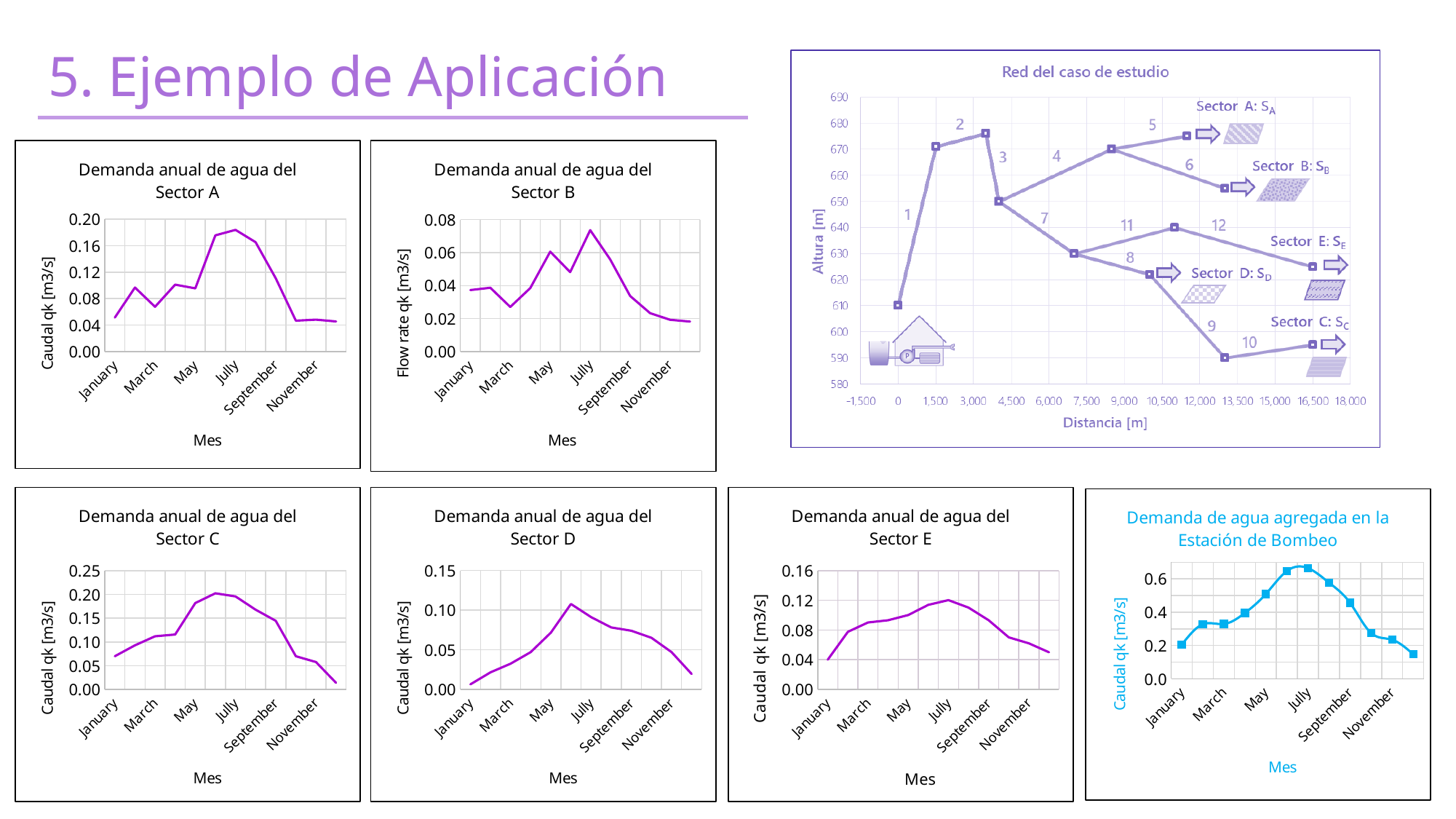
In the 'Demanda anual de agua del Sector B' chart, is the value for July greater or less than 0.06? greater What kind of chart is 'Demanda anual de agua del Sector A'? line chart In the 'Demanda anual de agua del Sector C' chart, is the value for June greater or less than 0.15? greater In the 'Demanda de agua agregada en la Estación de Bombeo' chart, is the value for December greater or less than 0.2? less In the 'Demanda anual de agua del Sector D' chart, which month has the lowest value? January What is the x-axis label of the 'Red del caso de estudio' chart? Distancia [m] In the 'Demanda de agua agregada en la Estación de Bombeo' chart, which is larger, the value for July or the value for January? July In the 'Demanda anual de agua del Sector A' chart, which month has the highest value? July In the 'Demanda anual de agua del Sector C' chart, which month has the lowest value? December How many months are plotted on the x axis of the 'Demanda de agua agregada en la Estación de Bombeo' chart? 12